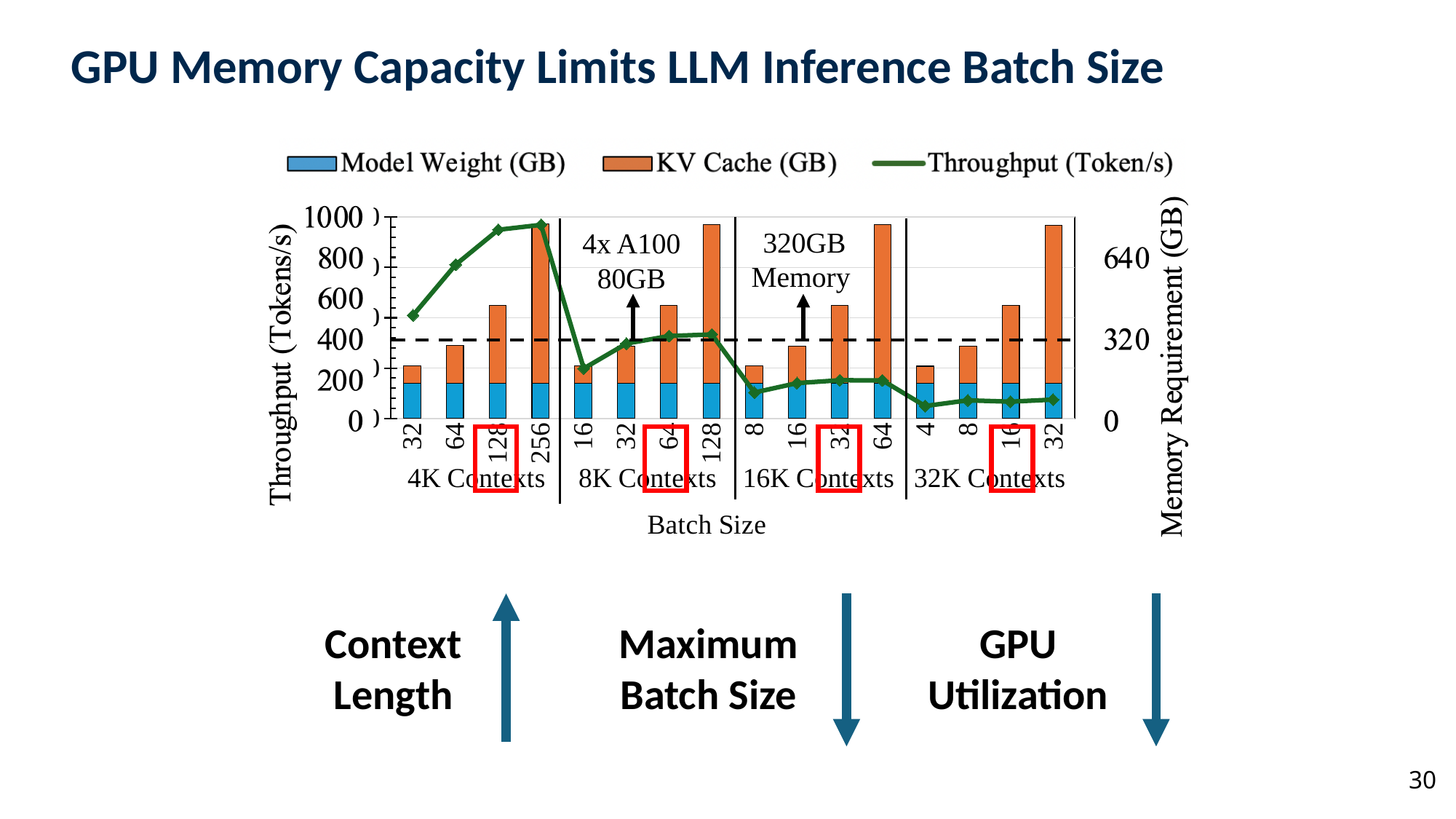
What is the title of the x axis? Batch Size What kind of chart is shown on the slide? A stacked bar chart combined with a line chart Which has the larger throughput: batch size 128 in 4K Contexts or batch size 16 in 8K Contexts? Batch size 128 in 4K Contexts Is the memory requirement for batch size 32 in 4K Contexts greater or less than 320 GB? less Which batch size and context group has the highest throughput? Batch size 256 in 4K Contexts Within the 4K Contexts group, does throughput rise or fall as batch size increases? rises How many context-length groups are shown along the x axis? 4 Which series are listed in the legend? Model Weight (GB), KV Cache (GB), Throughput (Token/s) How many series does the legend list? 3 Which context group has the lowest throughput values overall? 32K Contexts Is the throughput for batch size 256 in 4K Contexts greater or less than 800 Tokens/s? greater How many batch-size bars are plotted in total across all context groups? 16